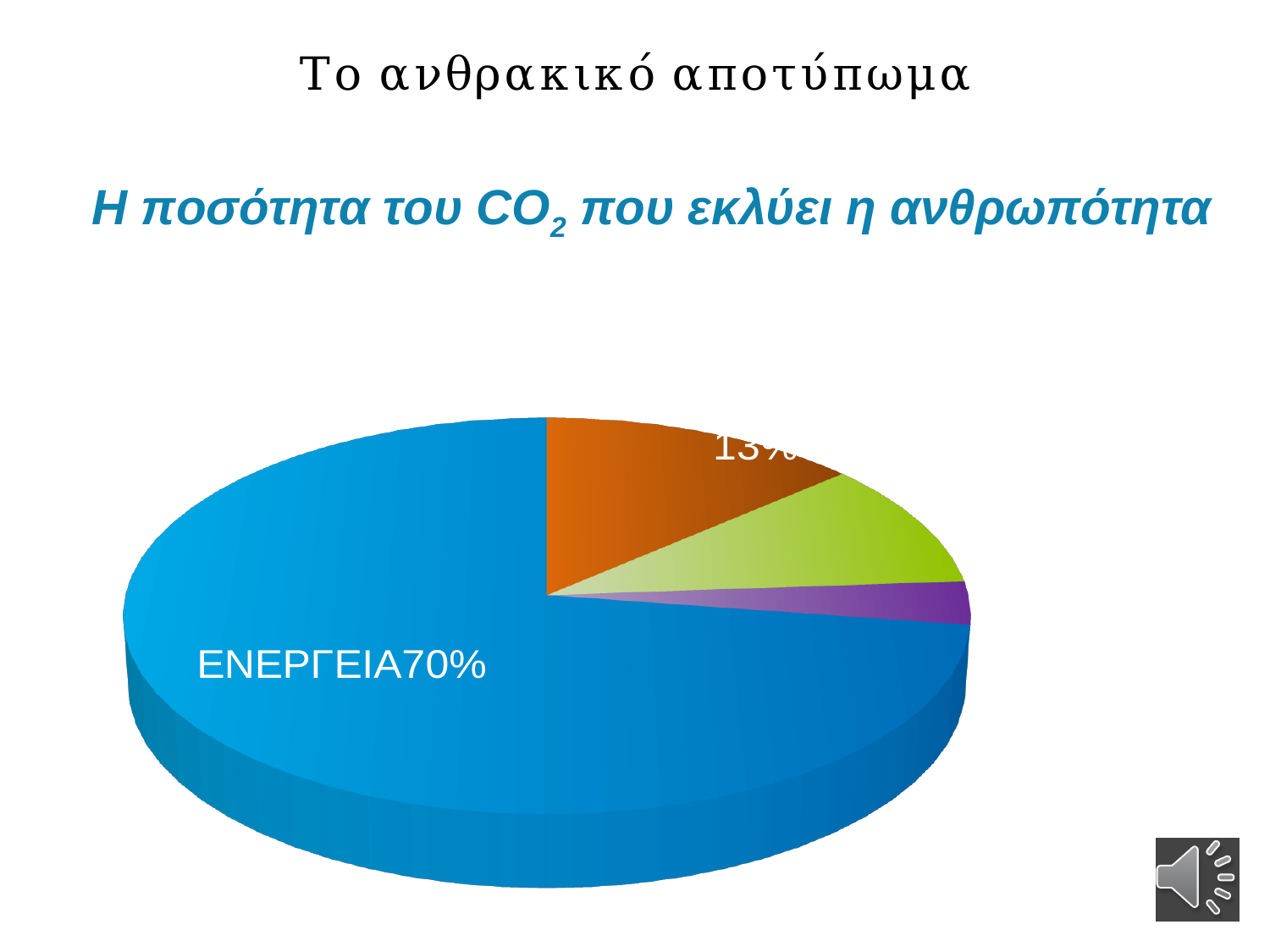
What percentage is shown for ΕΝΕΡΓΕΙΑ in the pie chart? 70% How many slices does the pie chart have? 4 What share of the pie does the ΕΝΕΡΓΕΙΑ slice represent? 70% Which colour slice is the smallest in the pie chart? Purple What is the title written above the pie chart? Η ποσότητα του CO2 που εκλύει η ανθρωπότητα What kind of chart is shown on the slide? Pie chart What percentage is printed on the orange slice of the pie chart? 13% What colour is the ΕΝΕΡΓΕΙΑ slice? Blue What is the difference in percentage points between the ΕΝΕΡΓΕΙΑ slice (70%) and the orange slice (13%)? 57 Which slice of the pie chart is the largest? ΕΝΕΡΓΕΙΑ Which is larger, the ΕΝΕΡΓΕΙΑ slice or the orange slice? ΕΝΕΡΓΕΙΑ